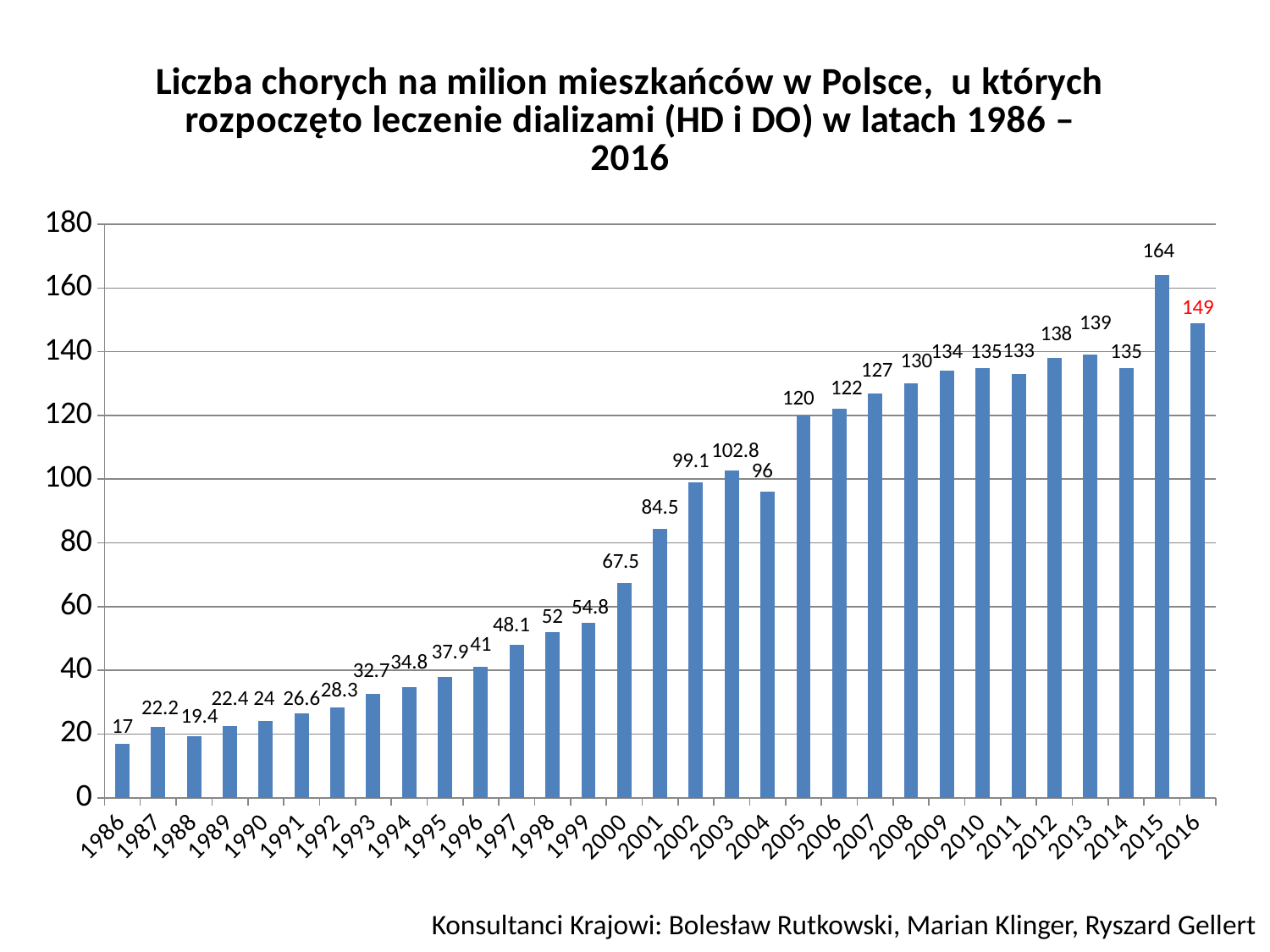
How many years are shown on the x axis? 31 What is the value for 2016? 149 Which year has the highest value? 2015 Which year has the lowest value? 1986 What is the difference between the values for 2001 and 2000? 17 Is the value for 2005 greater or less than 100? greater What is the difference between the values for 2015 and 2016? 15 What kind of chart is this? bar chart Which is larger, the value for 2004 or the value for 2002? 2002 Do the values generally rise or fall from 1986 to 2016? rise What is the value for 1986? 17 What is the value for 2003? 102.8